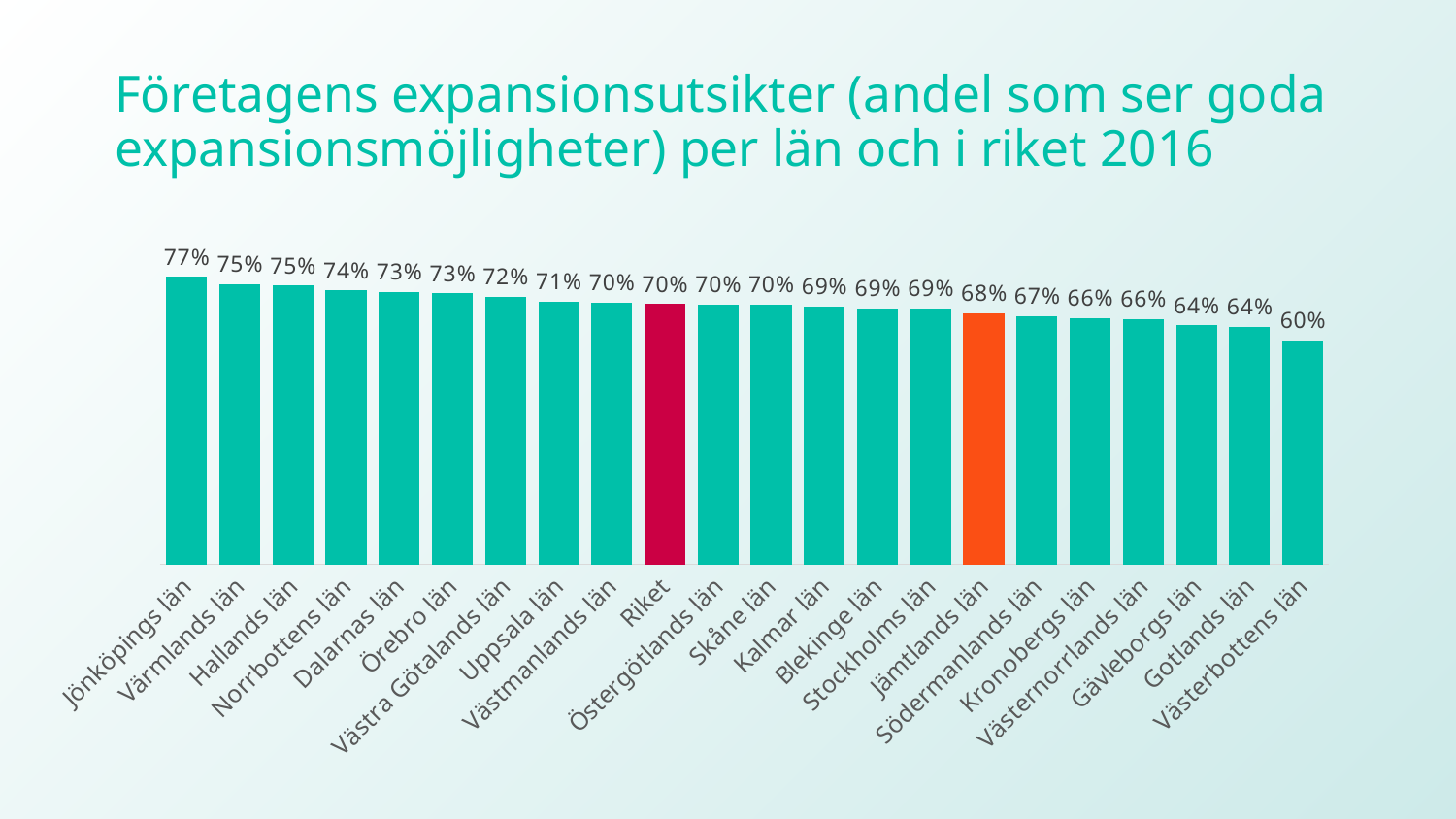
Which category is shown with an orange bar? Jämtlands län Which category has the lowest value? Västerbottens län What kind of chart is shown on the slide? Bar chart What is the value for Västerbottens län? 60% How many categories are shown in the chart? 22 What is the difference between the values for Riket and Jämtlands län? 2% Which category has the highest value? Jönköpings län Which is larger, the value for Norrbottens län or the value for Gotlands län? Norrbottens län What is the value for Riket? 70% What is the difference between the values for Jönköpings län and Västerbottens län? 17% What is the value for Jämtlands län? 68% What is the value for Jönköpings län? 77%